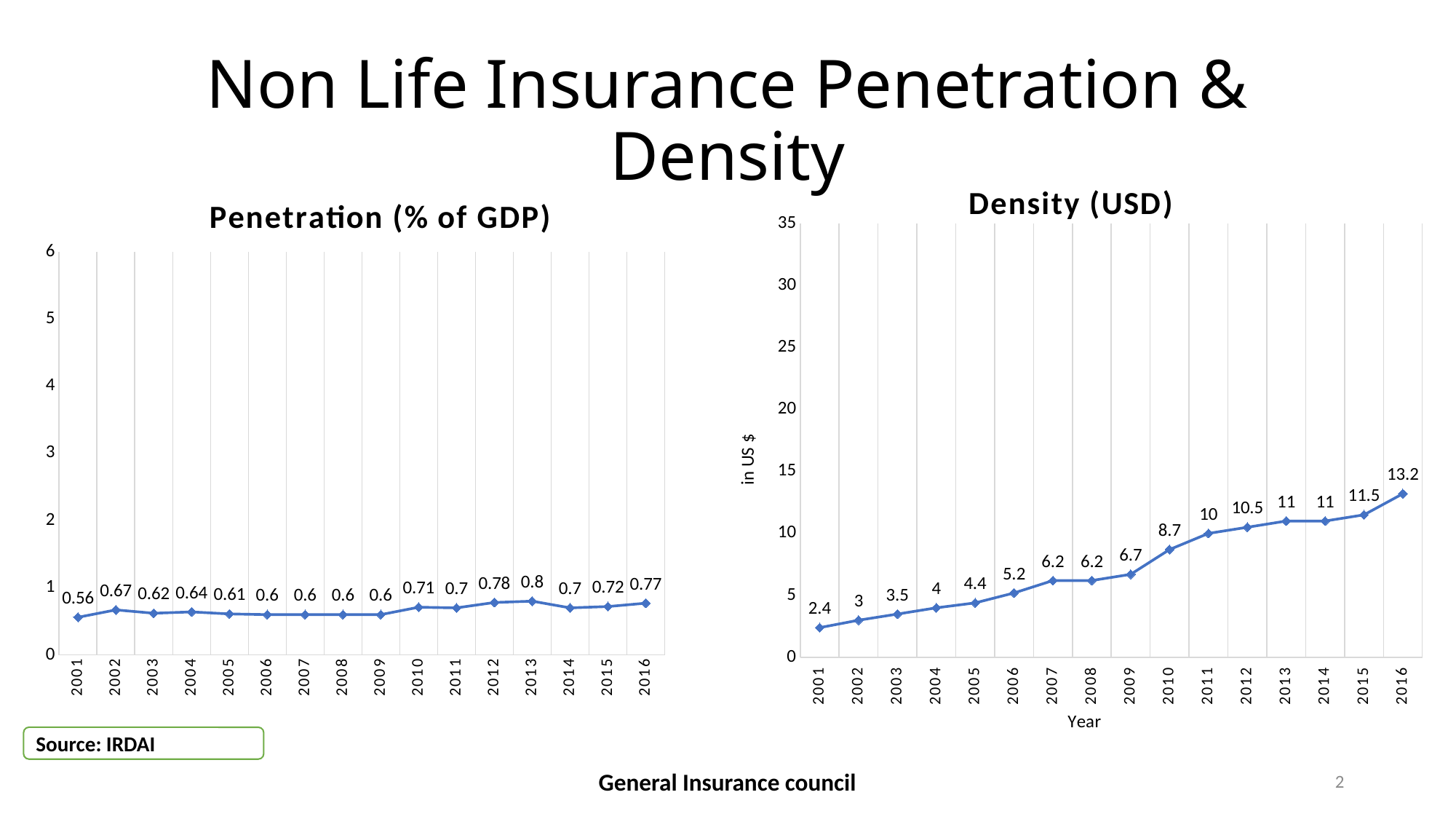
In the Penetration (% of GDP) chart, which year has the highest value? 2013 In the Density (USD) chart, what is the value for 2016? 13.2 In the Density (USD) chart, is the value for 2012 larger than the value for 2006? Yes In the Density (USD) chart, what is the value for 2010? 8.7 In the Penetration (% of GDP) chart, what is the value for 2001? 0.56 In the Penetration (% of GDP) chart, how many years are plotted? 16 In the Density (USD) chart, which year has the lowest value? 2001 In the Penetration (% of GDP) chart, what is the difference between the values for 2016 and 2001? 0.21 What kind of chart is the Density (USD) chart? line chart In the Density (USD) chart, what is the difference between the values for 2016 and 2001? 10.8 In the Penetration (% of GDP) chart, which year has the lowest value? 2001 In the Density (USD) chart, do the values generally rise or fall from 2001 to 2016? rise